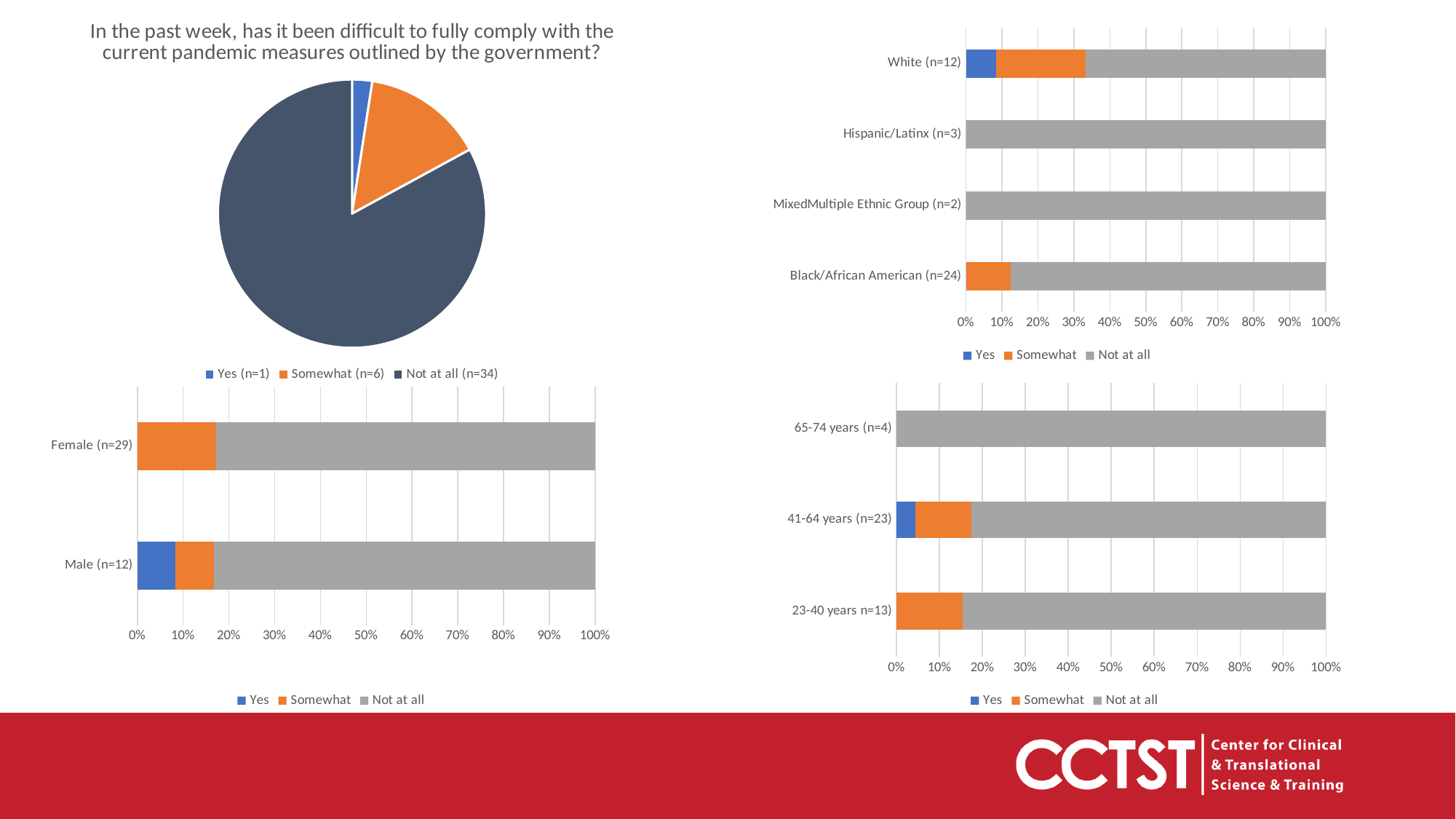
How many series does the legend of the top-left pie chart list? 3 In the bottom-right chart by age, what is the "Not at all" value for 65-74 years (n=4)? 100% In the bottom-left chart by gender, is the "Yes" value for Male (n=12) greater or less than 20%? less What kind of chart is the top-left chart titled "In the past week, has it been difficult to fully comply with the current pandemic measures outlined by the government?"? pie chart In the top-right chart by ethnicity, how many categories are shown? 4 In the top-left pie chart, how many respondents answered "Somewhat" according to the legend? 6 What kind of chart is the bottom-left chart showing Female (n=29) and Male (n=12)? bar chart In the bottom-left chart by gender, is the "Not at all" value for Female (n=29) greater or less than 80%? greater In the top-right chart by ethnicity, what is the "Not at all" value for Hispanic/Latinx (n=3)? 100% In the bottom-right chart by age, how many age groups are shown? 3 In the top-left pie chart, which response category has the largest slice? Not at all (n=34) In the top-right chart by ethnicity, is the "Somewhat" value for Black/African American (n=24) greater or less than 20%? less